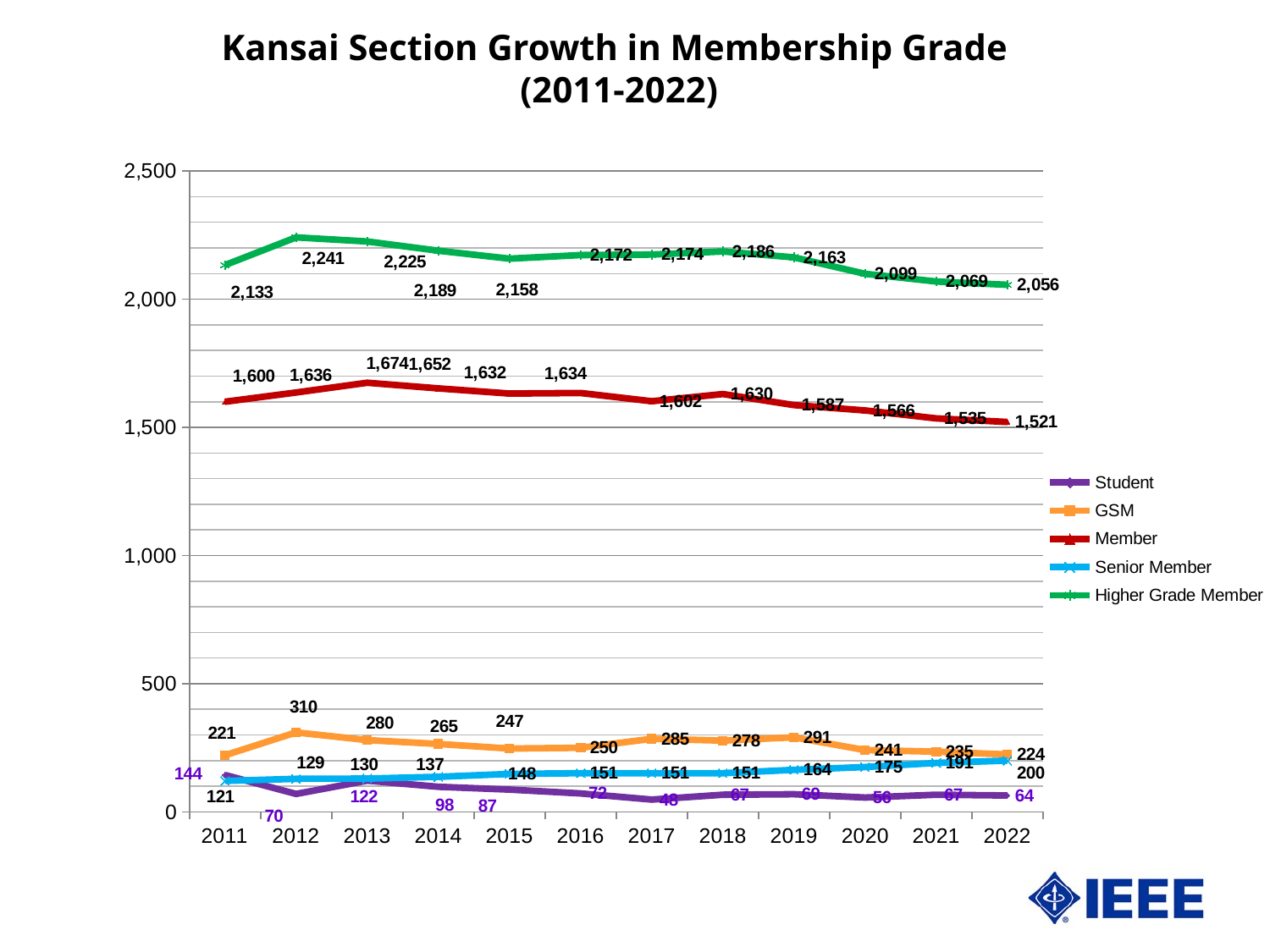
What is the Member value for 2013? 1,674 How many years are plotted along the x axis? 12 What kind of chart is shown on the slide? line chart What is the Student value for 2011? 144 In 2022, which is larger: the GSM value or the Senior Member value? GSM Does the Senior Member series generally rise or fall from 2011 to 2022? rise What is the Higher Grade Member value for 2022? 2,056 What is the difference between the Higher Grade Member values in 2012 and 2022? 185 In which year is the GSM series highest? 2012 By how much did the Senior Member value increase from 2011 to 2022? 79 How many series does the legend list? 5 In which year is the Member series lowest? 2022